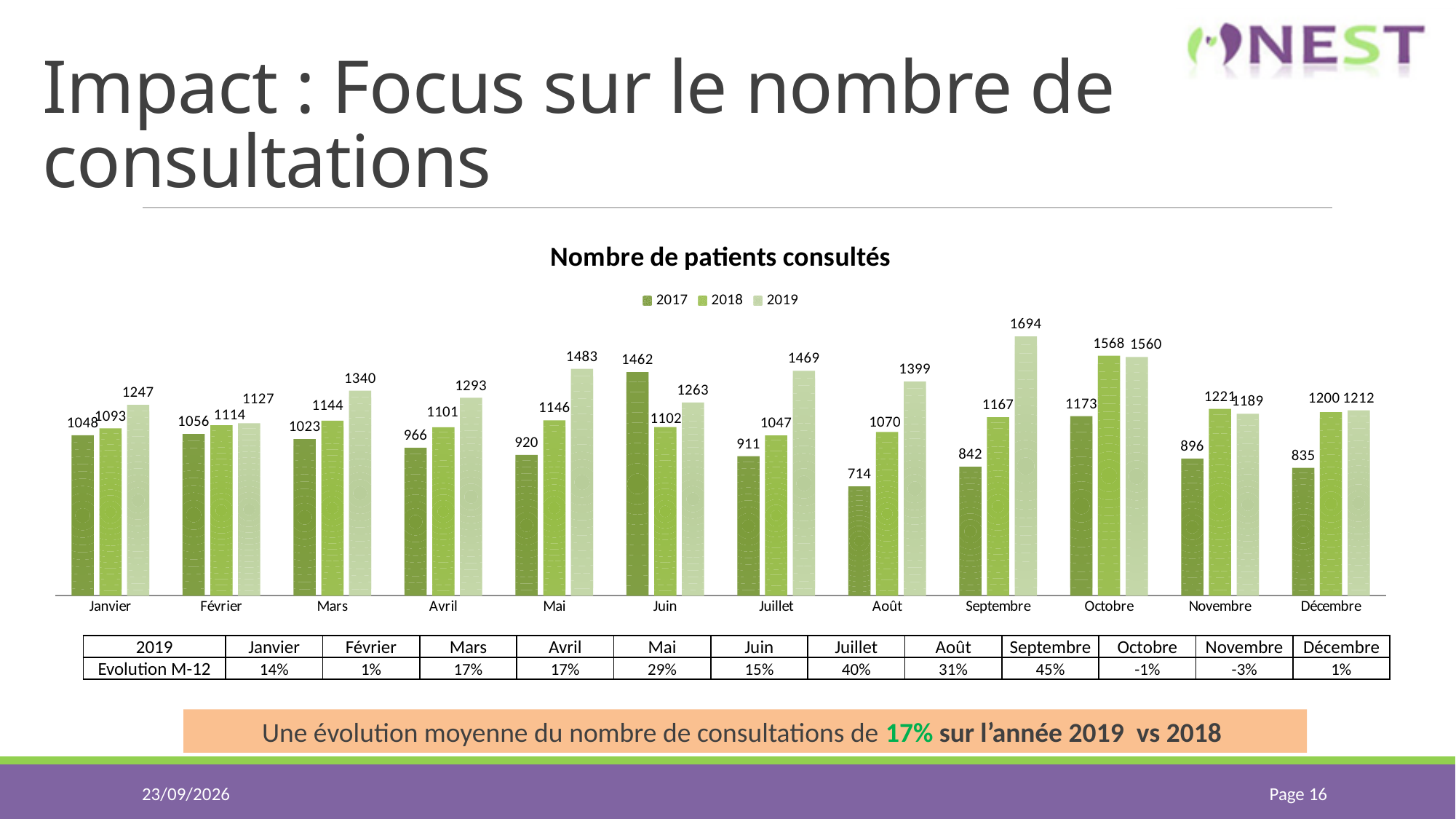
What is the title of the chart? Nombre de patients consultés What type of chart is shown on the slide? bar chart What is the value for 2018 in Octobre? 1568 What is the value for 2017 in Août? 714 Which month has the highest value for the 2017 series? Juin What is the difference between the 2019 and 2018 values in Mai? 337 In Juin, which series has the larger value, 2017 or 2019? 2017 What is the value for 2019 in Septembre? 1694 How many series does the chart legend list? 3 Which month has the highest value for the 2019 series? Septembre Which month has the lowest value for the 2017 series? Août How many months are shown on the x axis of the chart? 12